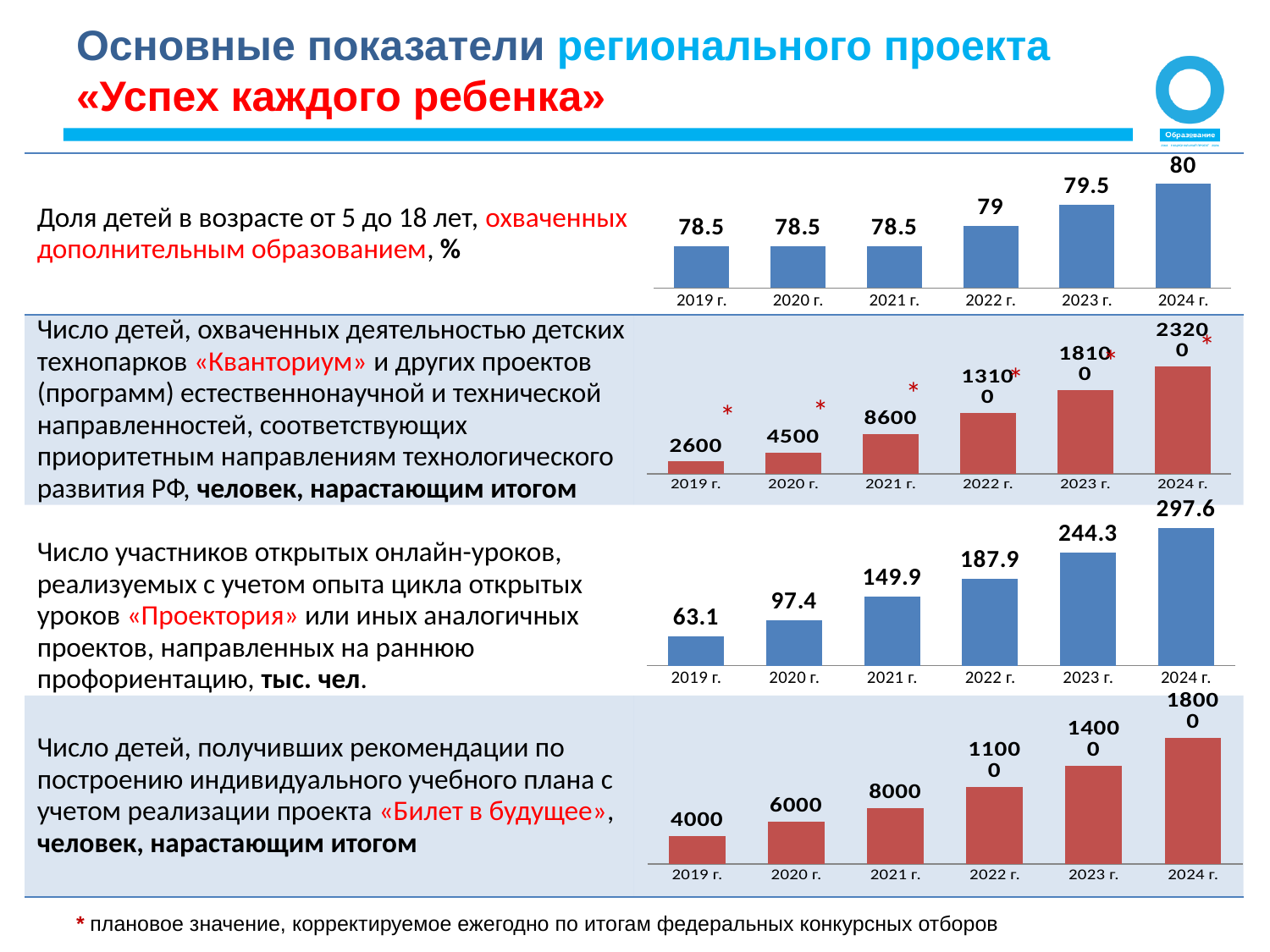
How many years (categories) are shown on the x axis of the bottom chart («Билет в будущее»)? 6 In the second chart from the top (children covered by «Кванториум» technoparks), what is the value for 2021 г.? 8600 In the top chart (share of children aged 5 to 18 covered by additional education, %), what is the value for 2022 г.? 79 In the third chart from the top (participants of open online lessons «Проектория», тыс. чел.), what is the difference between the 2020 г. and 2019 г. values? 34.3 In the third chart from the top (participants of open online lessons «Проектория», тыс. чел.), which year has the highest value? 2024 г. In the top chart (share of children covered by additional education, %), what is the difference between the 2024 г. and 2019 г. values? 1.5 In the third chart from the top (participants of open online lessons «Проектория», тыс. чел.), what is the value for 2023 г.? 244.3 What type of chart is the top chart (share of children covered by additional education, %)? bar chart In the bottom chart (children who received recommendations under «Билет в будущее»), is the value for 2021 г. larger or smaller than the value for 2019 г.? larger In the top chart (share of children aged 5 to 18 covered by additional education, %), what is the value for 2024 г.? 80 In the second chart from the top (children covered by «Кванториум» technoparks), which year has the lowest value? 2019 г. In the bottom chart (children who received recommendations under «Билет в будущее»), what is the value for 2020 г.? 6000